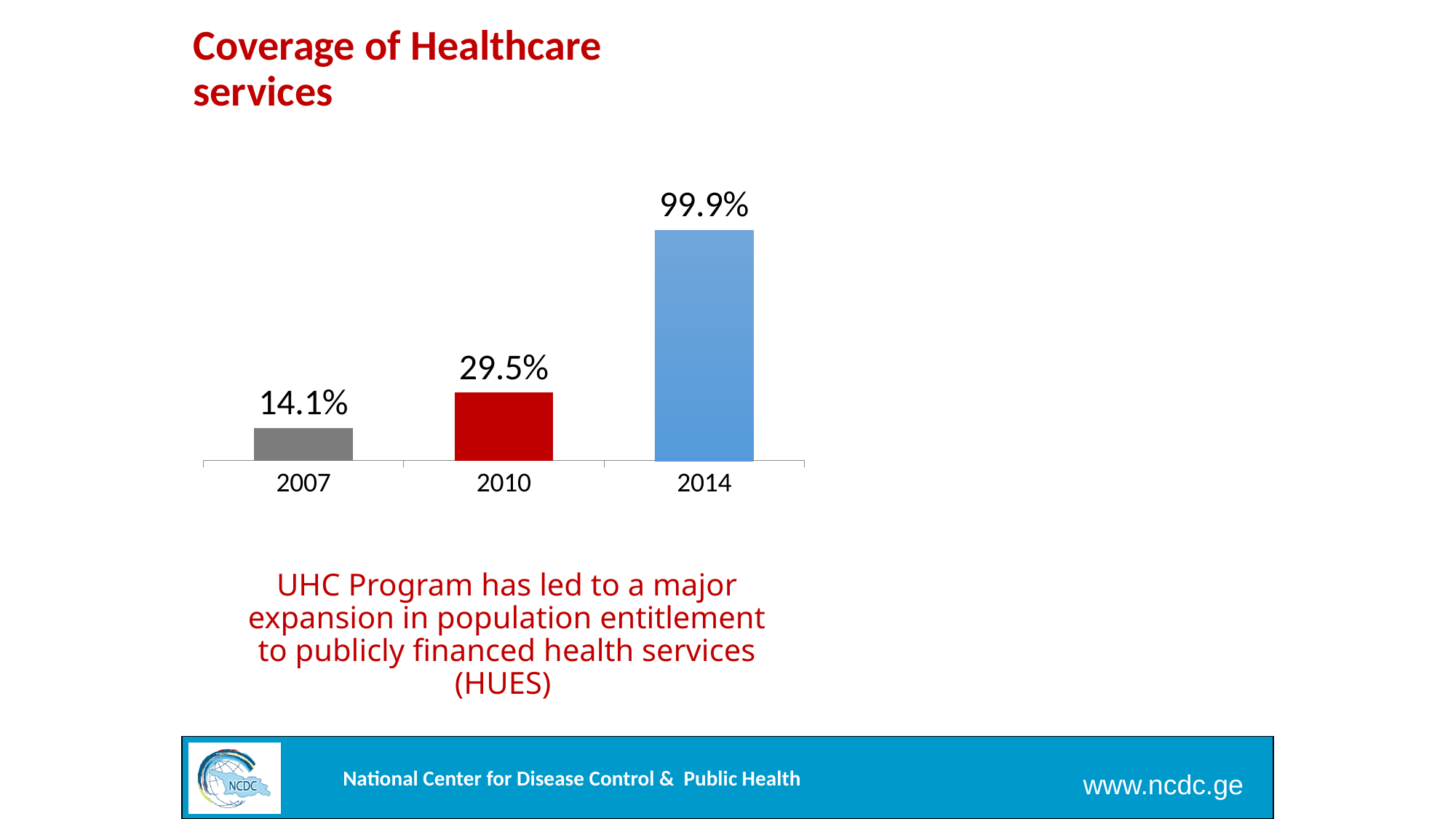
What is the difference between the values for 2010 and 2007? 15.4% Which year has the lowest value? 2007 Which is larger, the value for 2010 or the value for 2007? 2010 What is the value for 2014? 99.9% What is the difference between the values for 2014 and 2010? 70.4% What is the value for 2007? 14.1% How many years are shown on the chart? 3 What kind of chart is shown on the slide? bar chart Which year has the highest value? 2014 Do the values rise or fall from 2007 to 2014? rise What colour is the bar for 2010? red What is the value for 2010? 29.5%